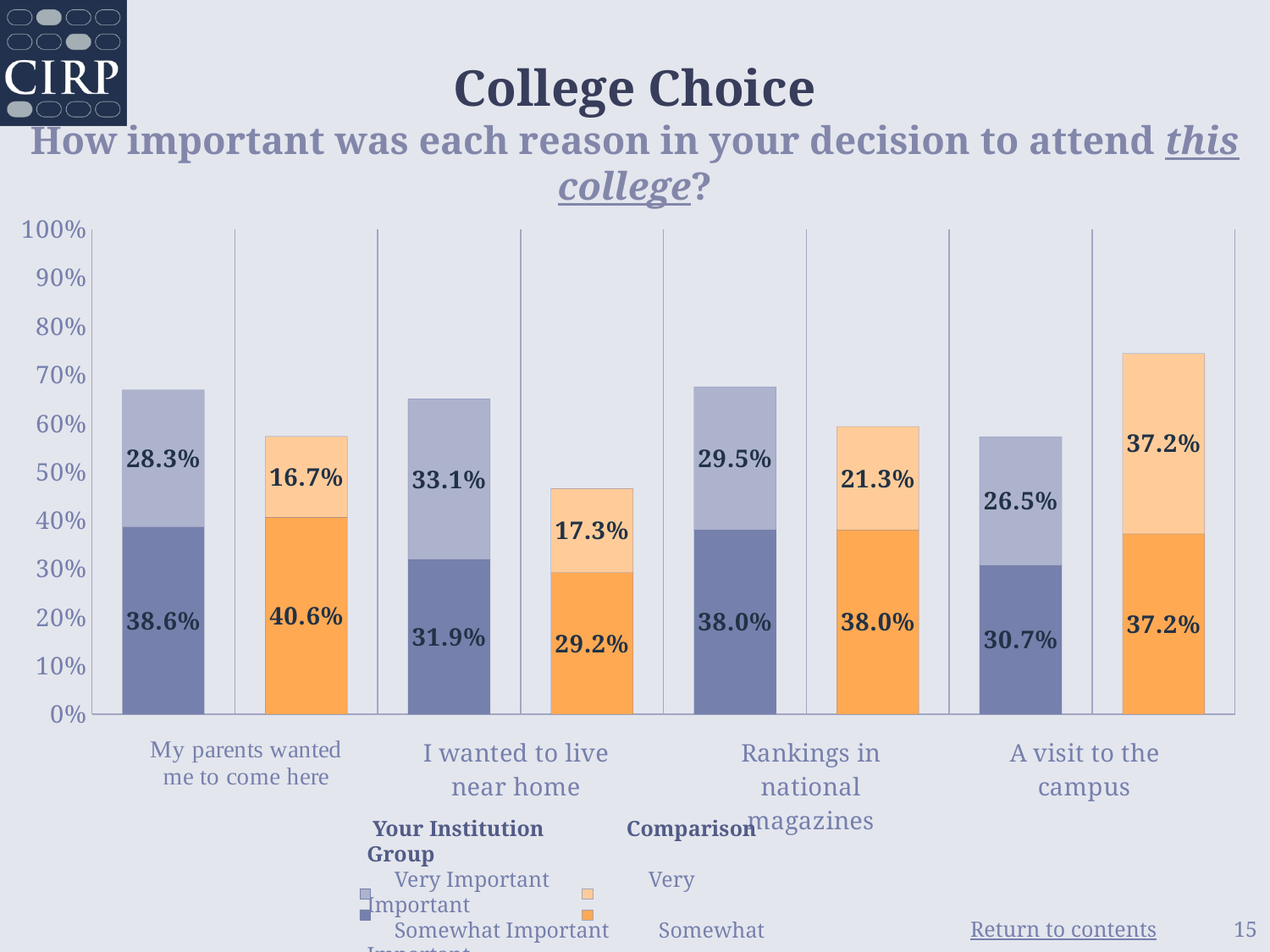
What percentage of the Comparison Group rated "A visit to the campus" as Very Important? 37.2% What percentage of Your Institution students rated "I wanted to live near home" as Very Important? 33.1% What is the total percentage (Very Important plus Somewhat Important) for the Comparison Group bar for "A visit to the campus"? 74.4% What percentage of Your Institution students rated "My parents wanted me to come here" as Somewhat Important? 38.6% What is the total percentage (Very Important plus Somewhat Important) for the Your Institution bar for "My parents wanted me to come here"? 66.9% Among the Comparison Group bars, which reason has the highest Very Important percentage? A visit to the campus What is the difference between the Very Important percentages for Your Institution and the Comparison Group for "I wanted to live near home"? 15.8% What percentage of the Comparison Group rated "Rankings in national magazines" as Somewhat Important? 38.0% How many reasons (categories) are shown along the x axis? 4 Which is larger: the Very Important percentage for Your Institution or for the Comparison Group for "My parents wanted me to come here"? Your Institution Among the Your Institution bars, which reason has the lowest Somewhat Important percentage? A visit to the campus What kind of chart is shown on the slide? stacked bar chart